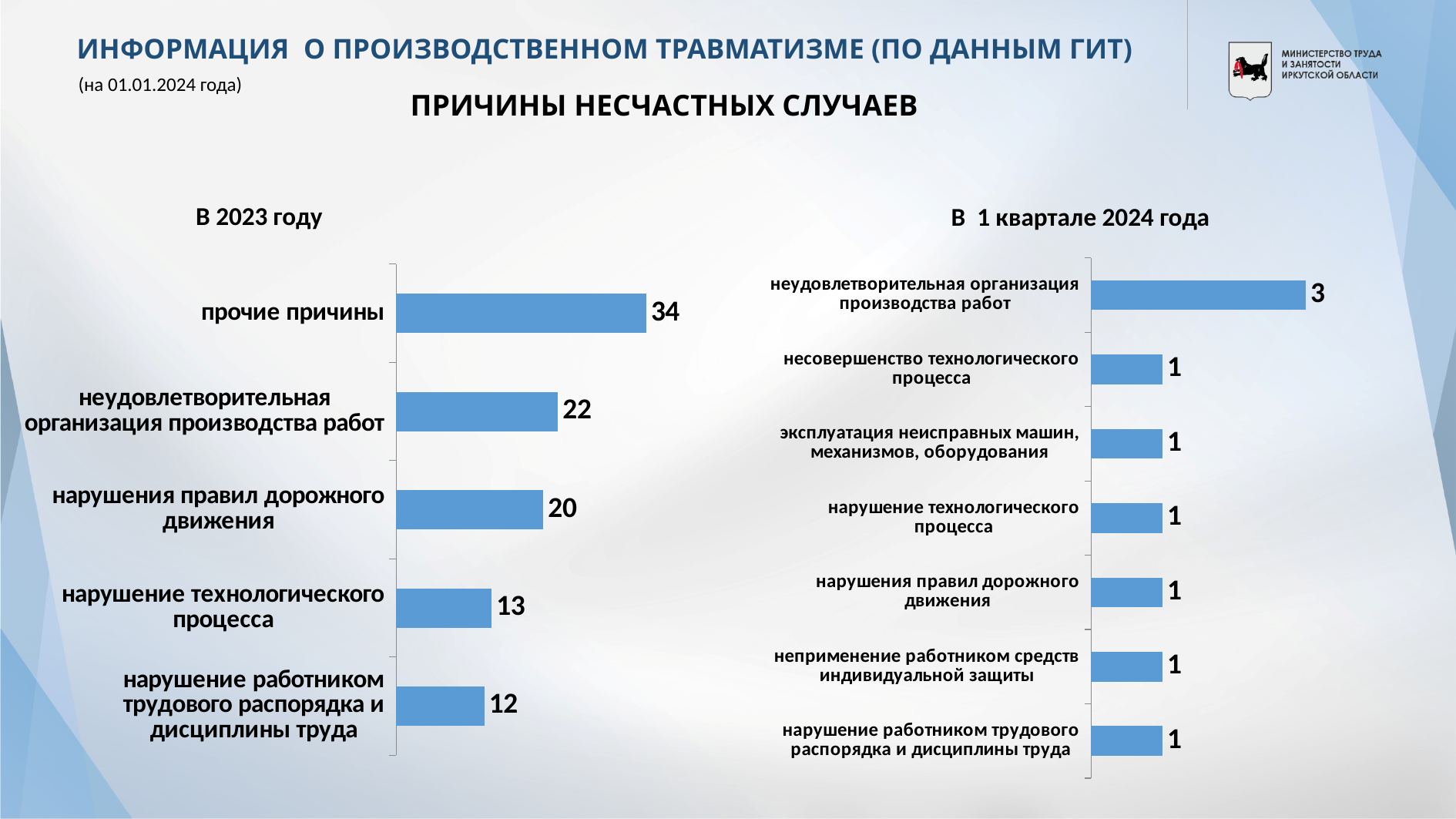
In the chart "В 1 квартале 2024 года", which category has the highest value? неудовлетворительная организация производства работ In the chart "В 2023 году", what is the value for "нарушения правил дорожного движения"? 20 In the chart "В 2023 году", which category has the highest value? прочие причины In the chart "В 2023 году", which category has the lowest value? нарушение работником трудового распорядка и дисциплины труда How many categories are shown in the chart "В 1 квартале 2024 года"? 7 In the chart "В 2023 году", which is larger: "нарушение технологического процесса" or "нарушение работником трудового распорядка и дисциплины труда"? нарушение технологического процесса In the chart "В 2023 году", what is the value for "прочие причины"? 34 How many categories are shown in the chart "В 2023 году"? 5 What type of chart is the chart "В 1 квартале 2024 года"? bar chart In the chart "В 1 квартале 2024 года", what is the value for "неудовлетворительная организация производства работ"? 3 In the chart "В 2023 году", what is the difference between "прочие причины" and "неудовлетворительная организация производства работ"? 12 In the chart "В 1 квартале 2024 года", what is the difference between "неудовлетворительная организация производства работ" and "несовершенство технологического процесса"? 2